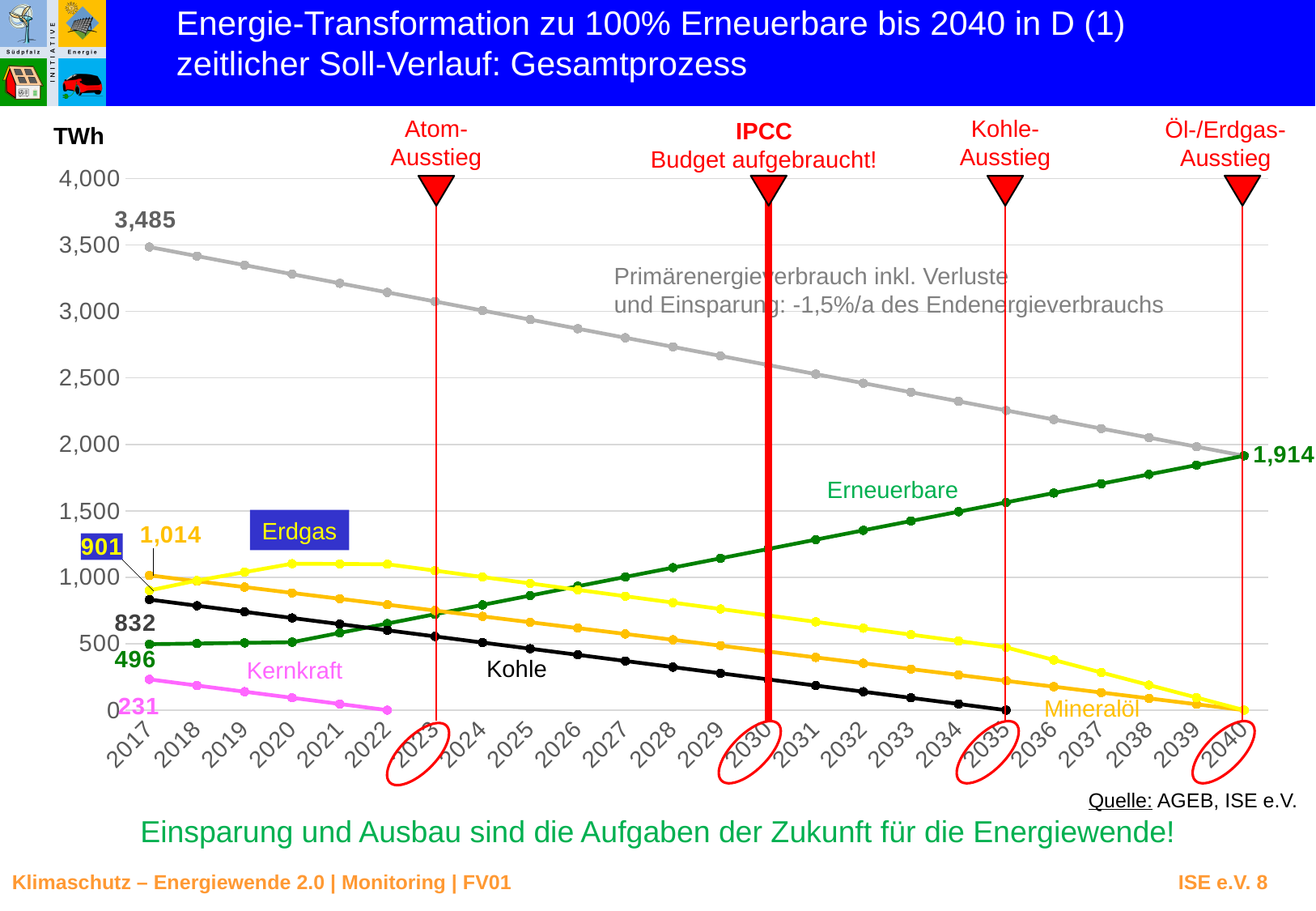
What is the value of Erneuerbare in 2017? 496 By how much does Erneuerbare increase from 2017 to 2040? 1,418 What is the value of Kernkraft in 2017? 231 What is the value of Primärenergieverbrauch in 2017? 3,485 What is the value of Kohle in 2017? 832 Does the Primärenergieverbrauch line rise or fall from 2017 to 2040? fall What unit is shown on the y axis? TWh What value does the Erneuerbare line reach in 2040? 1,914 What is the value of Mineralöl in 2017? 1,014 What type of chart is shown on the slide? line chart Is the value of Primärenergieverbrauch in 2040 greater or less than 2,000? less In 2017, which is larger: Mineralöl or Erdgas? Mineralöl